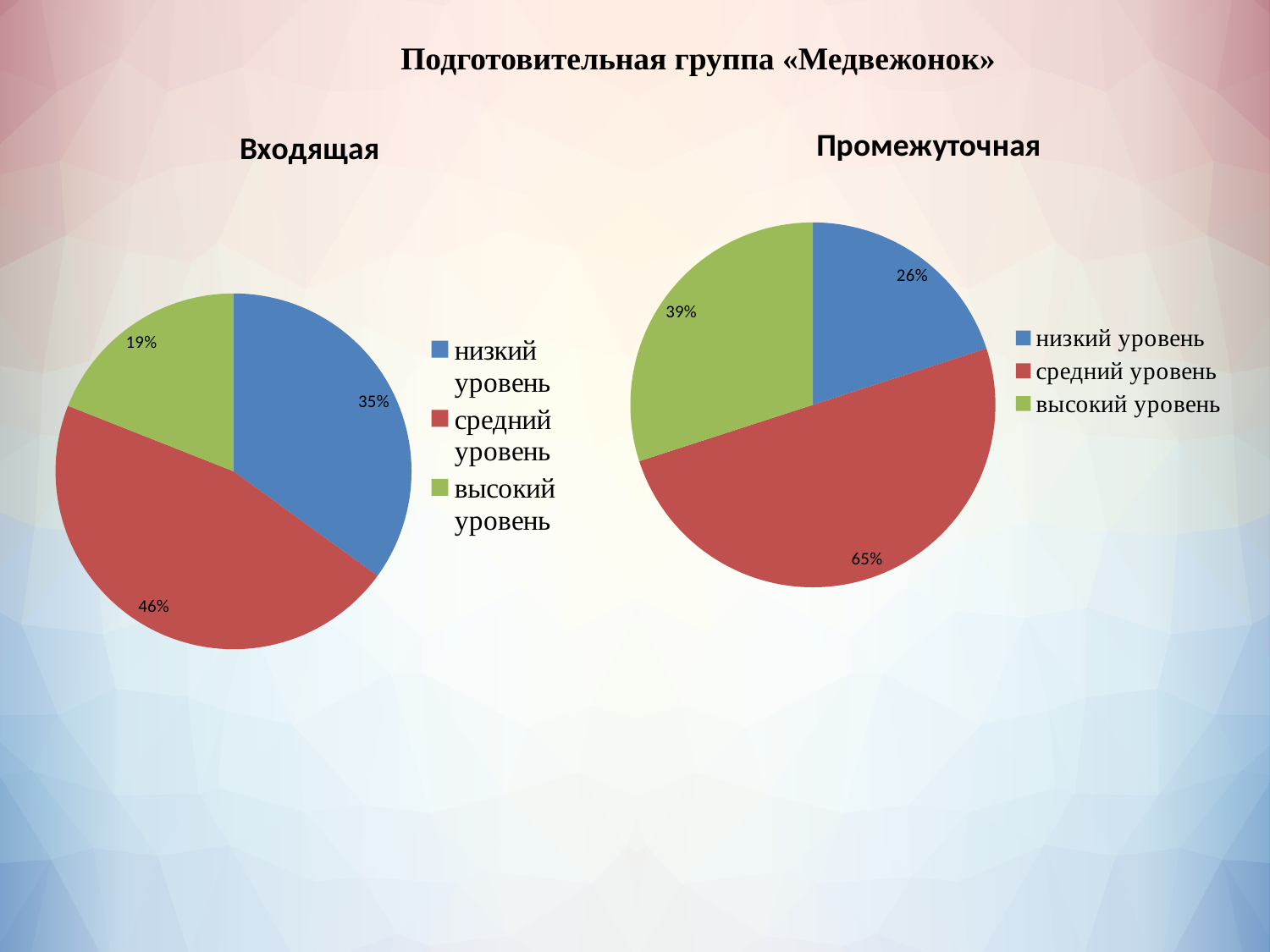
In the "Промежуточная" chart, which category has the smallest slice? низкий уровень In the "Входящая" chart, what is the difference between the shares of "средний уровень" and "высокий уровень"? 27% Which is larger: "высокий уровень" in the "Входящая" chart or "высокий уровень" in the "Промежуточная" chart? Промежуточная In the "Входящая" chart, what share does "высокий уровень" have? 19% In the "Входящая" chart, what share does "средний уровень" have? 46% In the "Входящая" chart, what share does "низкий уровень" have? 35% In the "Промежуточная" chart, what share does "высокий уровень" have? 39% In the "Промежуточная" chart, what share does "средний уровень" have? 65% What type of chart is the "Входящая" chart? pie chart In the "Входящая" chart, which category has the largest slice? средний уровень How many slices does the "Промежуточная" chart have? 3 In the "Промежуточная" chart, what share does "низкий уровень" have? 26%